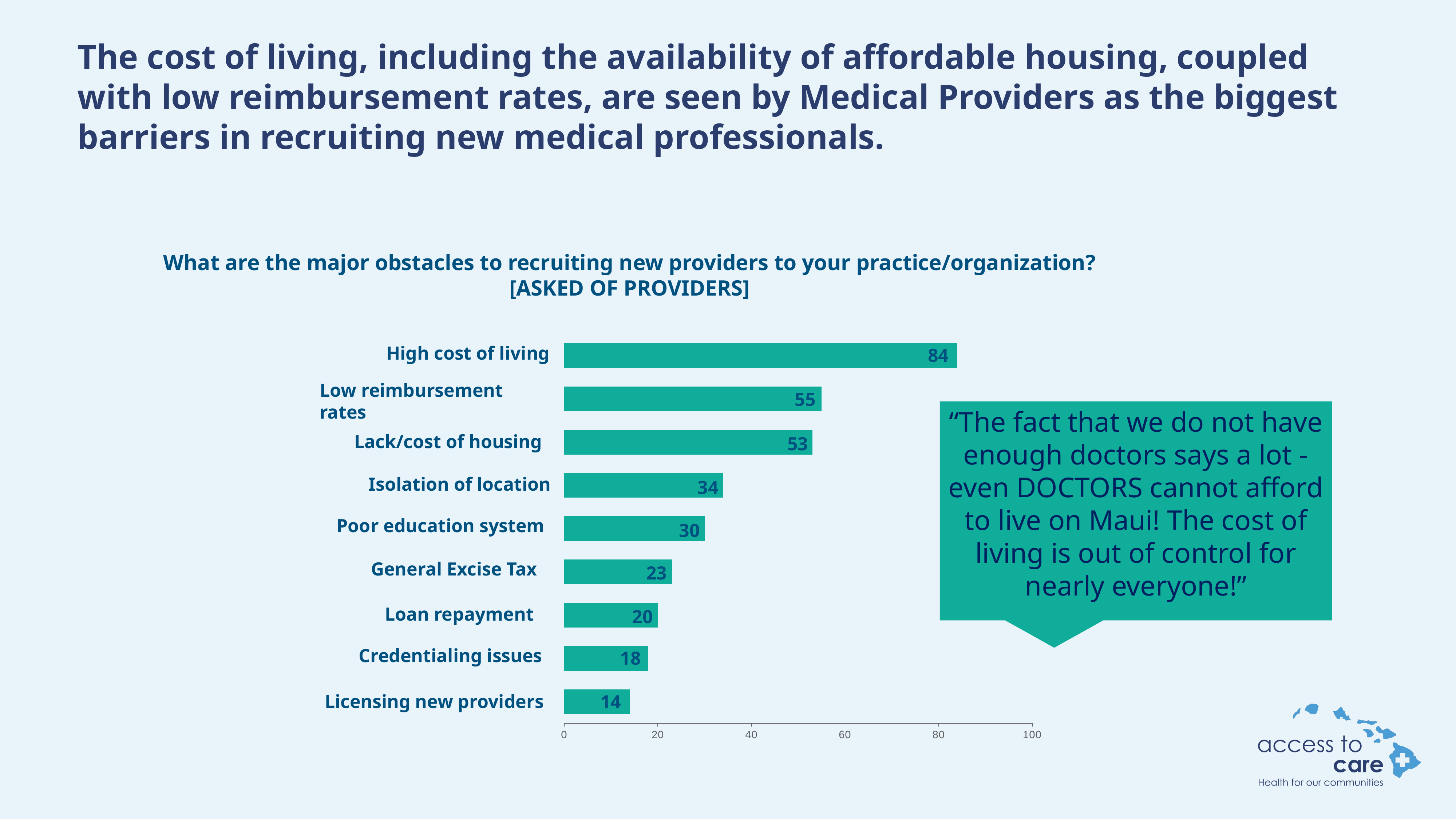
Is the value for Isolation of location greater or less than 40? less What kind of chart is shown on the slide? bar chart Which obstacle has the highest value? High cost of living Which obstacle has the lowest value? Licensing new providers What is the difference between the values for Isolation of location and Poor education system? 4 What is the maximum value shown on the horizontal axis? 100 What is the value for High cost of living? 84 What is the value for Lack/cost of housing? 53 What is the value for General Excise Tax? 23 What is the difference between the values for High cost of living and Low reimbursement rates? 29 How many obstacles are shown in the chart? 9 Which is larger, the value for Loan repayment or the value for Credentialing issues? Loan repayment